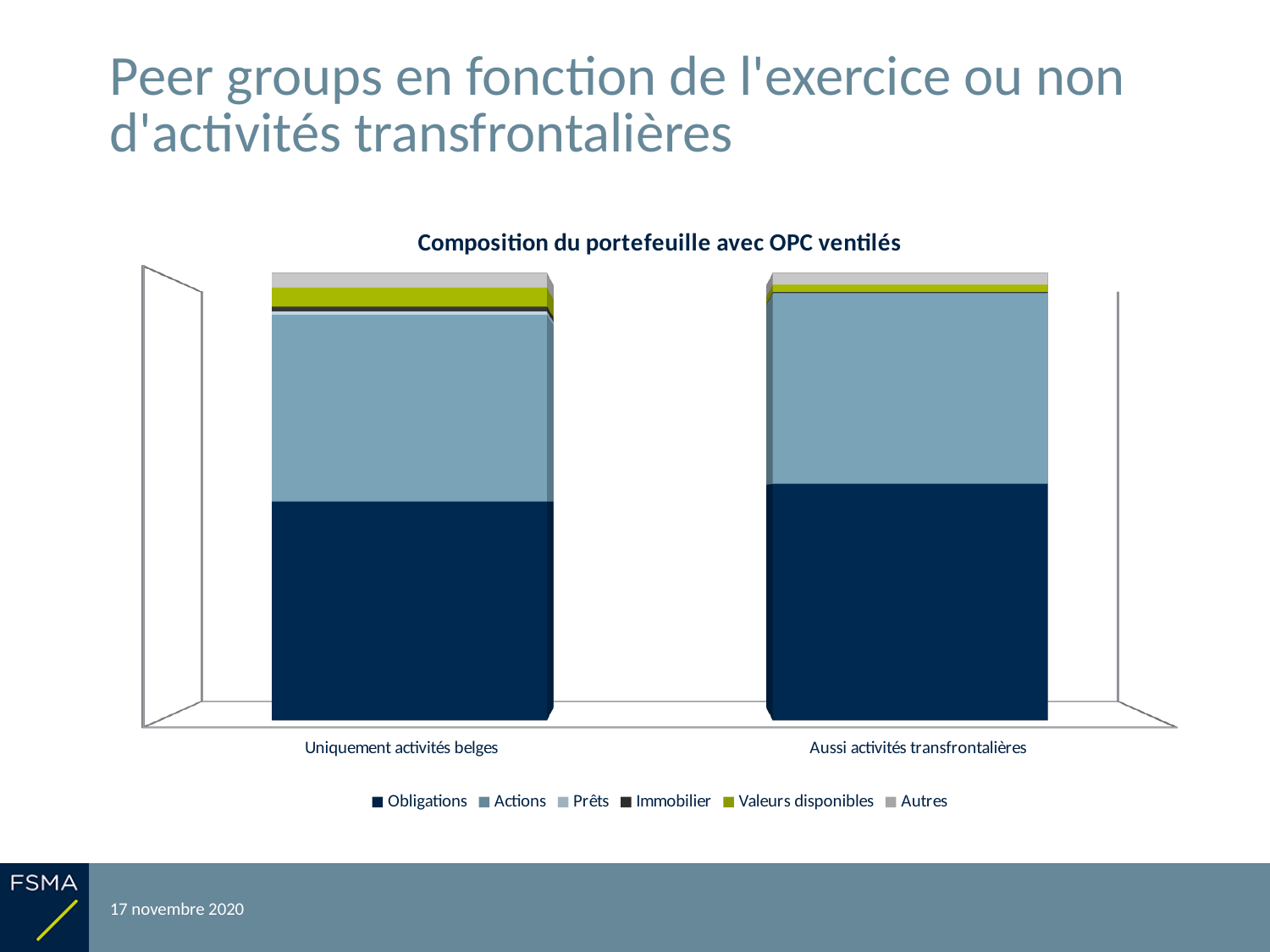
What is the title of the chart? Composition du portefeuille avec OPC ventilés How many series does the chart legend list? 6 What kind of chart is shown on the slide? Stacked bar chart Which series makes up the second-largest part of the bar for 'Uniquement activités belges'? Actions Which series is listed first in the chart legend? Obligations Is the 'Valeurs disponibles' segment larger for 'Uniquement activités belges' or for 'Aussi activités transfrontalières'? Uniquement activités belges What is the label of the right-hand bar on the chart? Aussi activités transfrontalières Is the 'Obligations' segment larger for 'Uniquement activités belges' or for 'Aussi activités transfrontalières'? Aussi activités transfrontalières Which series makes up the largest part of the bar for 'Uniquement activités belges'? Obligations How many categories (bars) are shown on the x axis of the chart? 2 Which series makes up the largest part of the bar for 'Aussi activités transfrontalières'? Obligations